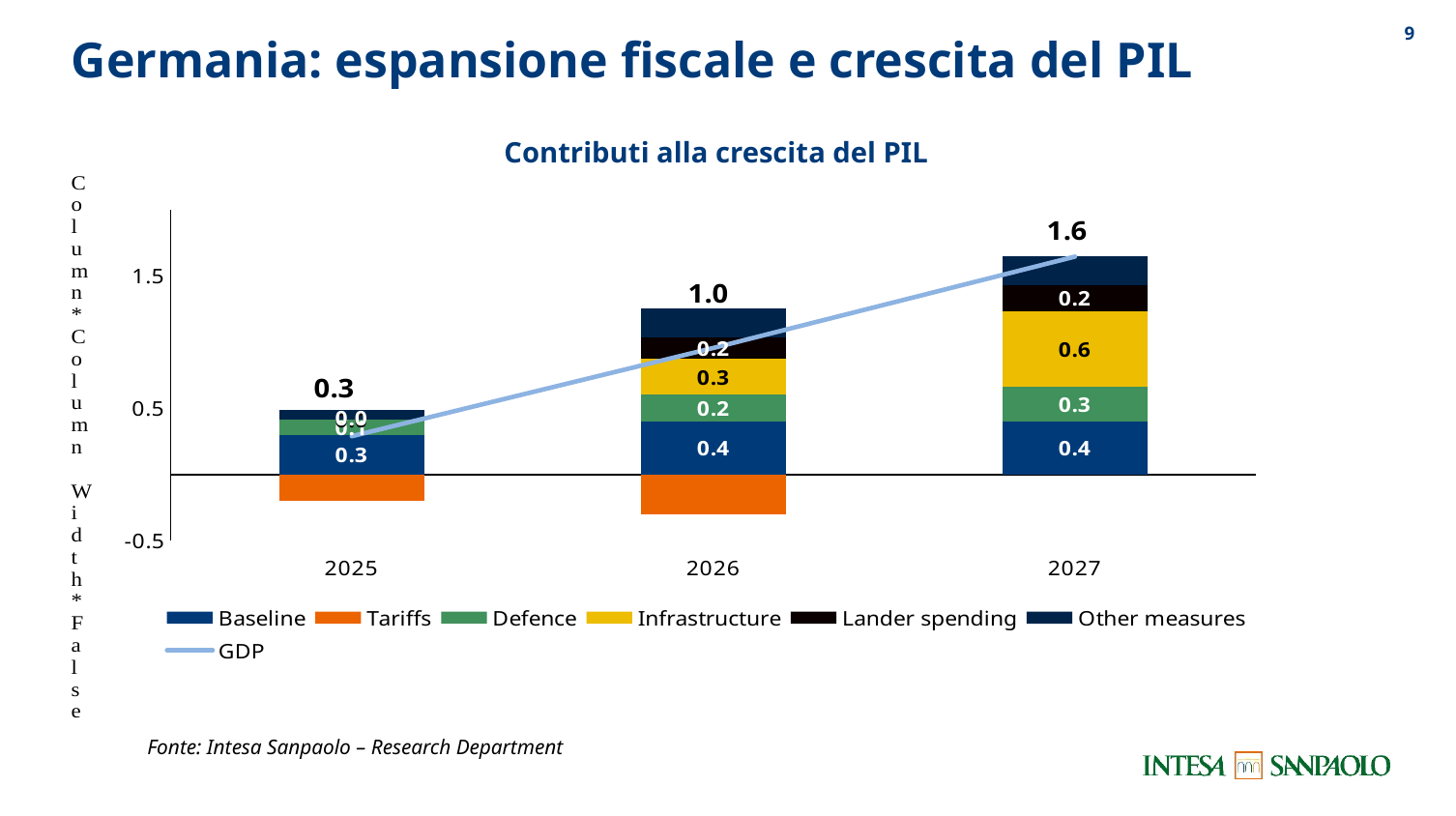
How many series does the legend list? 7 How many years are shown on the x axis of the chart? 3 In which year is the GDP value highest? 2027 Does the GDP line rise or fall from 2025 to 2027? rise What is the Infrastructure value for 2027? 0.6 What is the GDP value for 2027? 1.6 What is the difference between the GDP value for 2027 and the GDP value for 2026? 0.6 What is the title of the chart? Contributi alla crescita del PIL What is the Lander spending value for 2026? 0.2 What is the Baseline value for 2026? 0.4 Is the Tariffs value for 2026 greater or less than -0.5? greater What kind of chart is shown on the slide? combination bar and line chart